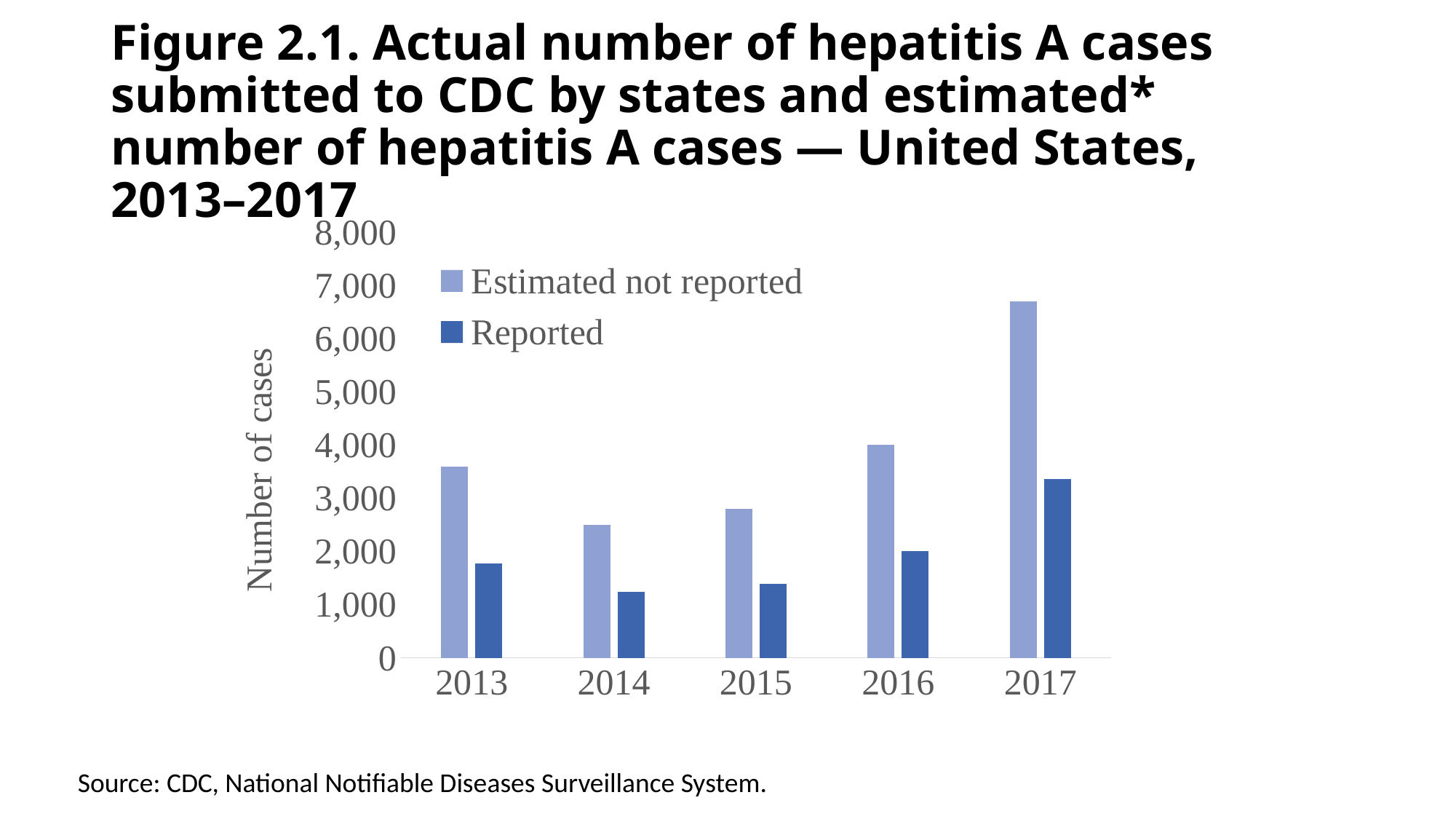
Is the value for Estimated not reported in 2017 greater or less than 6,000? greater Is the value for Reported in 2017 greater or less than 3,000? greater Which year has the highest value for Estimated not reported? 2017 Which year has the lowest value for Reported? 2014 In 2016, which is larger: Estimated not reported or Reported? Estimated not reported How many years are shown on the x axis? 5 Which year has the lowest value for Estimated not reported? 2014 What is the label of the y axis? Number of cases Is the value for Estimated not reported in 2015 greater or less than 3,000? less What type of chart is shown on the slide? bar chart How many series does the legend list? 2